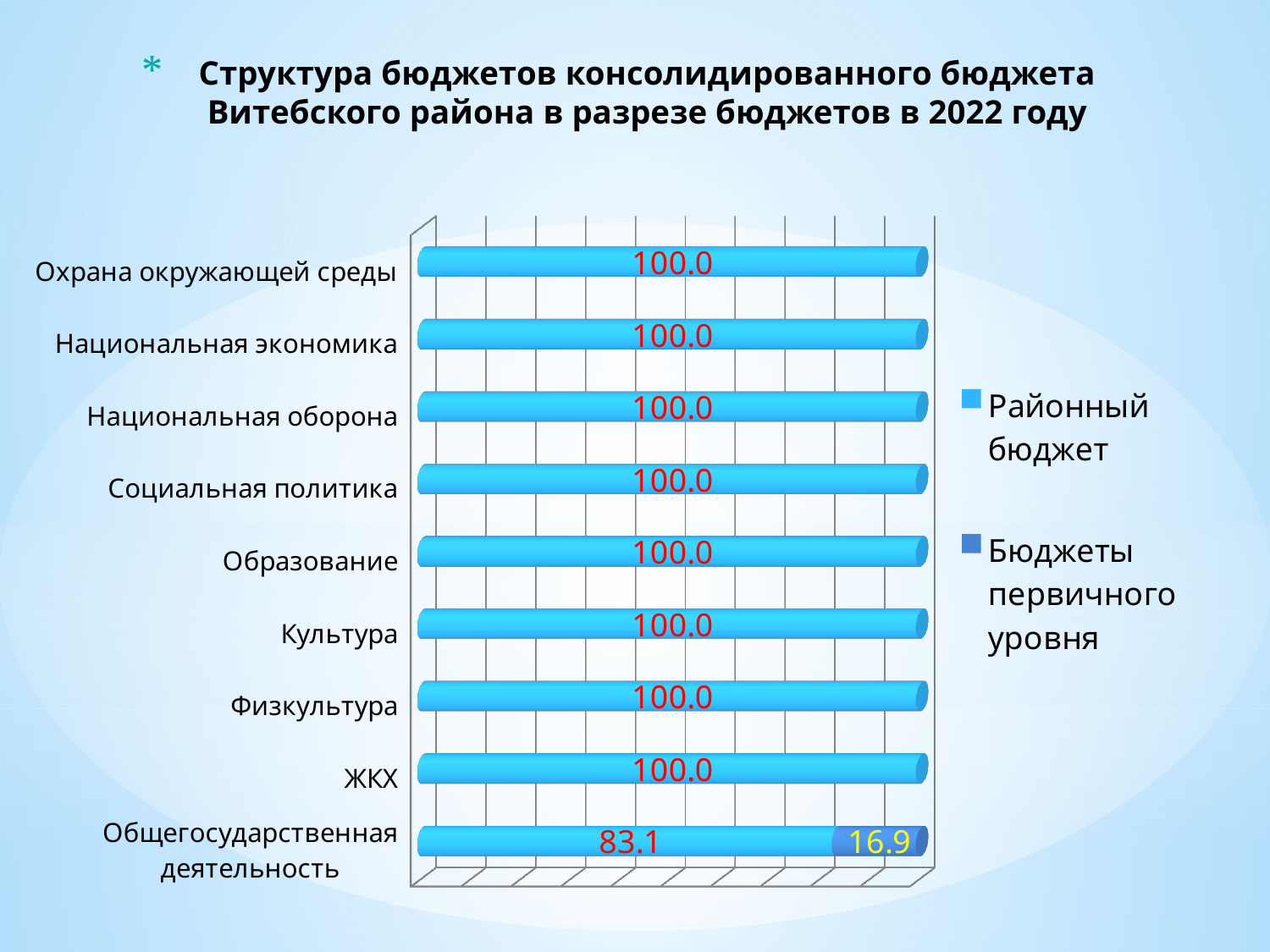
What is the difference between the Районный бюджет value and the Бюджеты первичного уровня value for Общегосударственная деятельность? 66.2 What is the value of Районный бюджет for ЖКХ? 100.0 What is the total of the stacked bar for Общегосударственная деятельность? 100.0 What is the value of Районный бюджет for Общегосударственная деятельность? 83.1 What is the value of Районный бюджет for Образование? 100.0 How many categories are shown on the chart? 9 Which is larger for Общегосударственная деятельность: Районный бюджет or Бюджеты первичного уровня? Районный бюджет Which category has the lowest value for Районный бюджет? Общегосударственная деятельность How many series does the legend list? 2 What kind of chart is shown on the slide? Bar chart What is the value of Бюджеты первичного уровня for Общегосударственная деятельность? 16.9 Which category is the only one with a visible Бюджеты первичного уровня segment? Общегосударственная деятельность